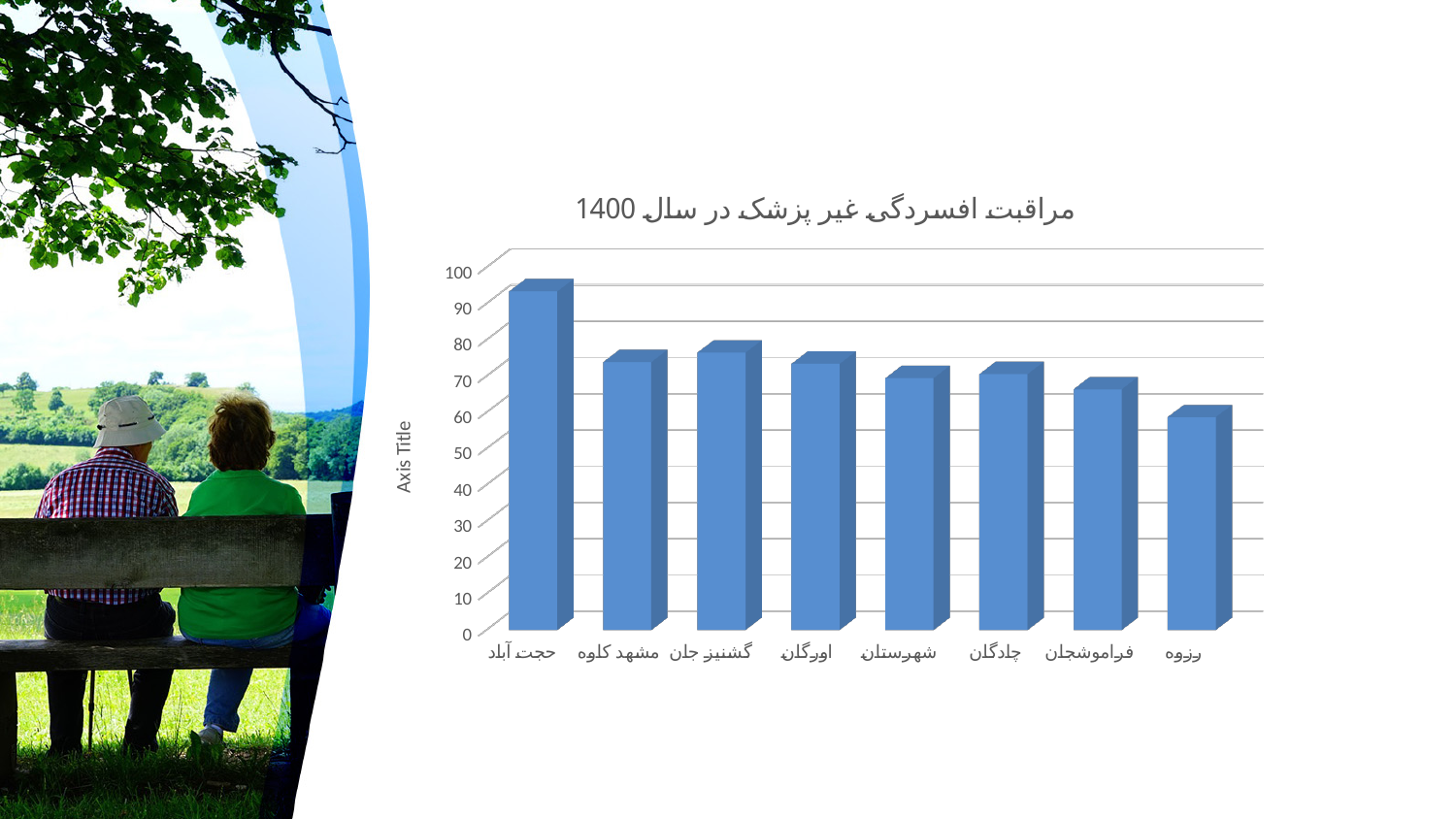
Is the value for رزوه greater or less than 70? less What kind of chart is shown on the slide? bar chart How many categories are plotted on the x axis? 8 What is the title of the chart? مراقبت افسردگی غیر پزشک در سال 1400 Which is larger, the value for حجت آباد or the value for رزوه? حجت آباد What label is shown on the vertical axis? Axis Title Is the value for فراموشجان greater or less than 70? less Which category has the lowest value? رزوه Which category has the highest value? حجت آباد Is the value for حجت آباد greater or less than 80? greater Which is larger, the value for مشهد کلوه or the value for فراموشجان? مشهد کلوه